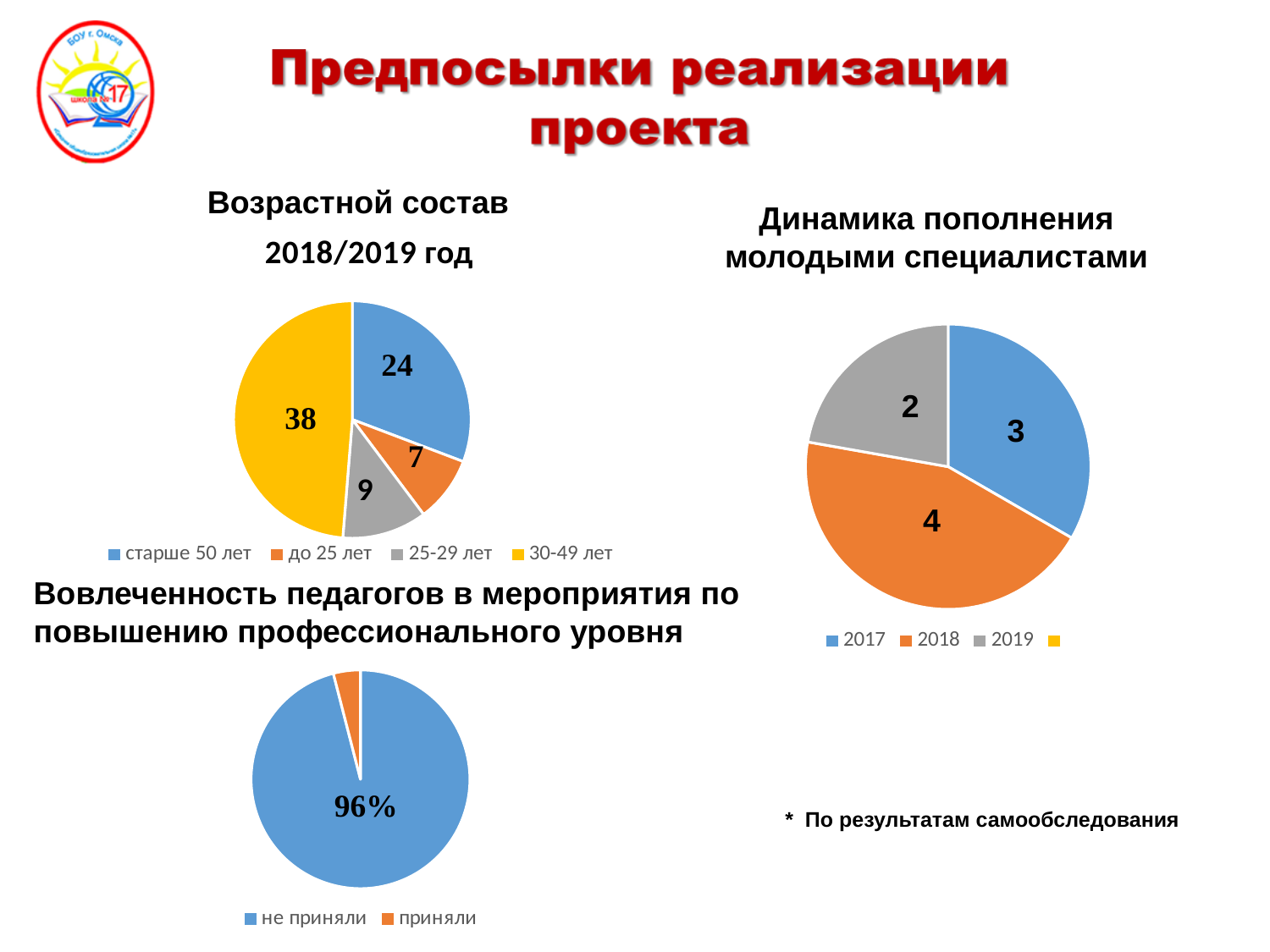
In the pie chart titled "Возрастной состав 2018/2019 год", which age group has the largest slice? 30-49 лет In the pie chart titled "Возрастной состав 2018/2019 год", what is the difference between the "30-49 лет" value and the "старше 50 лет" value? 14 In the pie chart titled "Возрастной состав 2018/2019 год", what is the value for the "30-49 лет" slice? 38 In the pie chart titled "Динамика пополнения молодыми специалистами", which year has the smallest value? 2019 In the pie chart titled "Возрастной состав 2018/2019 год", what is the value for the "до 25 лет" slice? 7 In the pie chart titled "Возрастной состав 2018/2019 год", how many age groups are shown? 4 In the pie chart at the bottom left titled "Вовлеченность педагогов в мероприятия по повышению профессионального уровня", what percentage is printed on the blue "не приняли" slice? 96% In the pie chart titled "Динамика пополнения молодыми специалистами", what is the total of the values for 2017, 2018 and 2019? 9 In the pie chart titled "Возрастной состав 2018/2019 год", which age group has the smallest slice? до 25 лет In the pie chart titled "Динамика пополнения молодыми специалистами", which year has the largest value? 2018 What type of chart is used for "Динамика пополнения молодыми специалистами"? Pie chart In the pie chart titled "Динамика пополнения молодыми специалистами", what is the value for 2018? 4